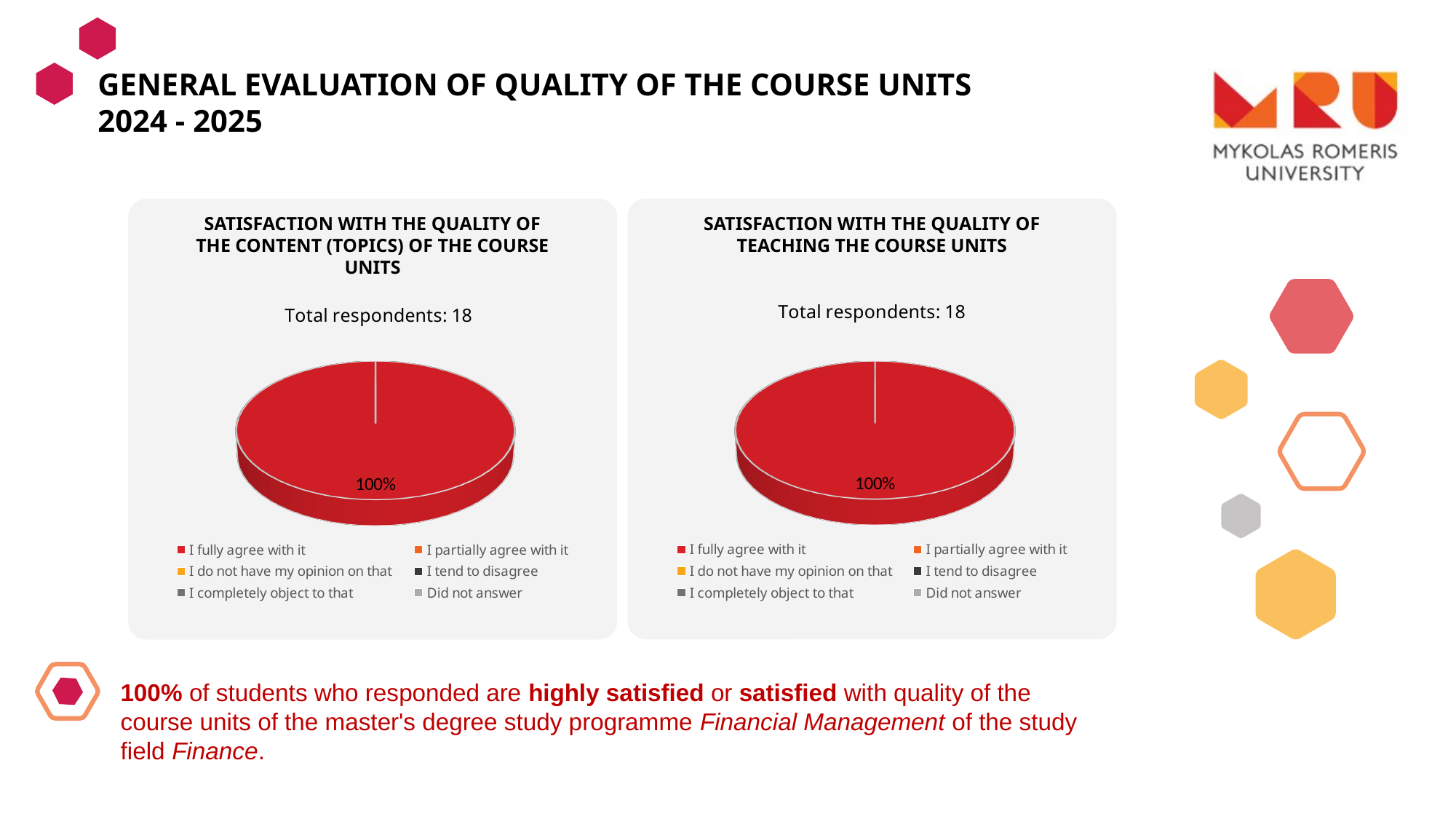
In the left chart, how many entries does the legend list? 6 What kind of chart is the right chart on the slide? Pie chart In the right chart, how many entries does the legend list? 6 What is the title of the right chart on the slide? Satisfaction with the quality of teaching the course units In the right chart, how many respondents are reported in total? 18 In the left chart, which response category makes up the largest share of the pie? I fully agree with it In the left chart, how many respondents are reported in total? 18 What kind of chart is the left chart on the slide? Pie chart In the left chart, how many slices are visible in the pie? 1 In the chart titled 'Satisfaction with the quality of teaching the course units', what share of the pie is labelled 'I fully agree with it'? 100% In the chart titled 'Satisfaction with the quality of the content (topics) of the course units', what share of the pie is labelled 'I fully agree with it'? 100% In the right chart, which response category makes up the largest share of the pie? I fully agree with it